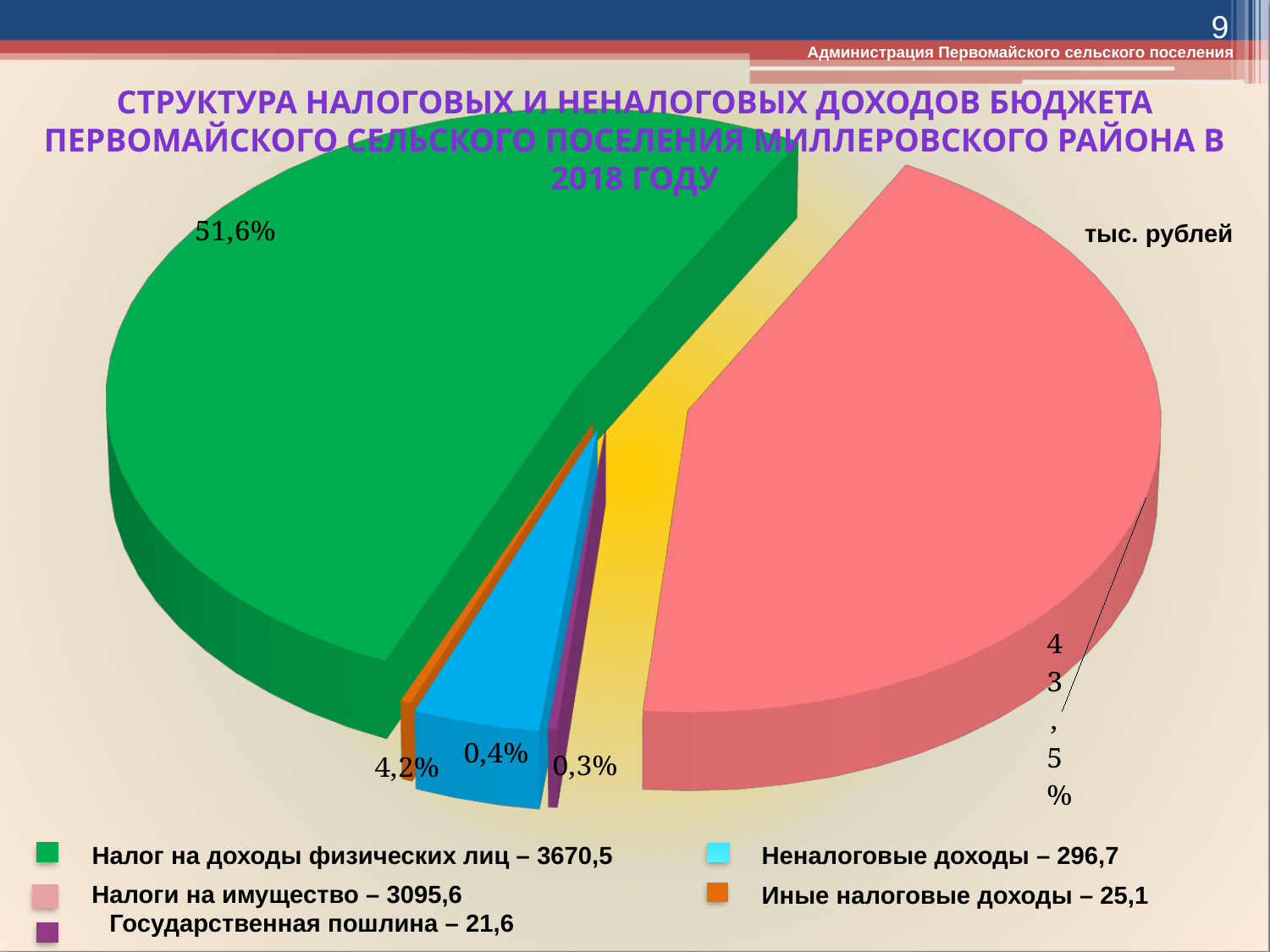
What is the difference between Налог на доходы физических лиц and Налоги на имущество? 574,9 In what units are the values of the pie chart given? тыс. рублей What kind of chart is shown on the slide? pie chart Which category has the largest value in the pie chart? Налог на доходы физических лиц What is the value for Неналоговые доходы? 296,7 What is the value for Налог на доходы физических лиц? 3670,5 How many categories does the legend of the pie chart list? 5 Which category has the smallest value in the pie chart? Государственная пошлина Which is larger: Иные налоговые доходы or Неналоговые доходы? Неналоговые доходы What is the value for Государственная пошлина? 21,6 What share of the pie does Налог на доходы физических лиц represent? 51,6% What is the value for Налоги на имущество? 3095,6